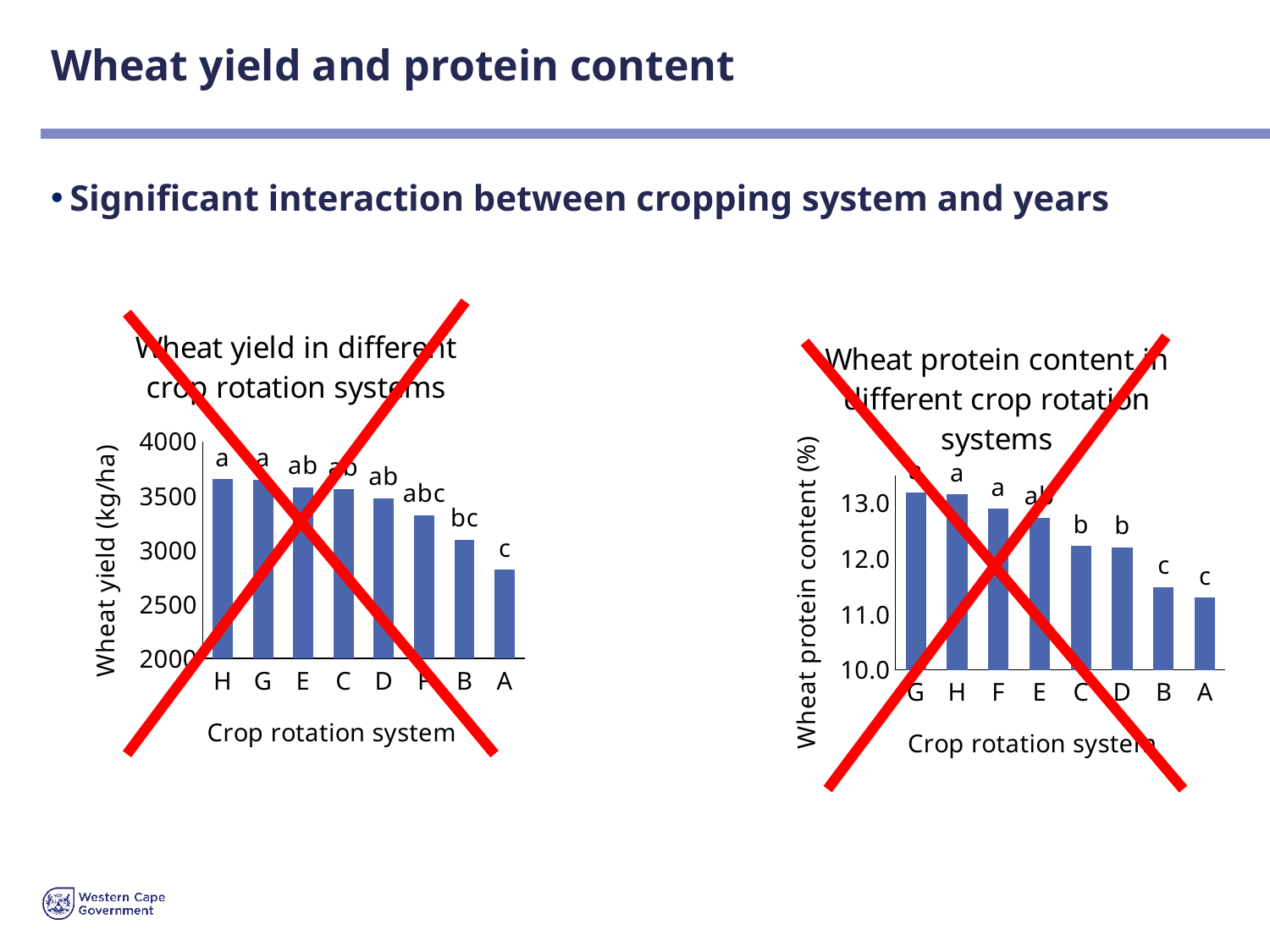
In the left chart, 'Wheat yield in different crop rotation systems', is the wheat yield for system A greater or less than 3000? less In the left chart, 'Wheat yield in different crop rotation systems', which crop rotation system has the lowest wheat yield? A In the right chart, 'Wheat protein content in different crop rotation systems', is the wheat protein content for system C greater or less than 12.0? greater In the right chart, 'Wheat protein content in different crop rotation systems', which crop rotation system has the lowest wheat protein content? A What is the y-axis label of the right chart, 'Wheat protein content in different crop rotation systems'? Wheat protein content (%) In the left chart, 'Wheat yield in different crop rotation systems', is the wheat yield for system H greater or less than 3500? greater In the left chart, 'Wheat yield in different crop rotation systems', do the wheat yields rise or fall from left to right along the x axis? fall How many crop rotation systems are shown on the x axis of the left chart, 'Wheat yield in different crop rotation systems'? 8 What kind of chart is the left chart, 'Wheat yield in different crop rotation systems'? bar chart How many crop rotation systems are shown on the x axis of the right chart, 'Wheat protein content in different crop rotation systems'? 8